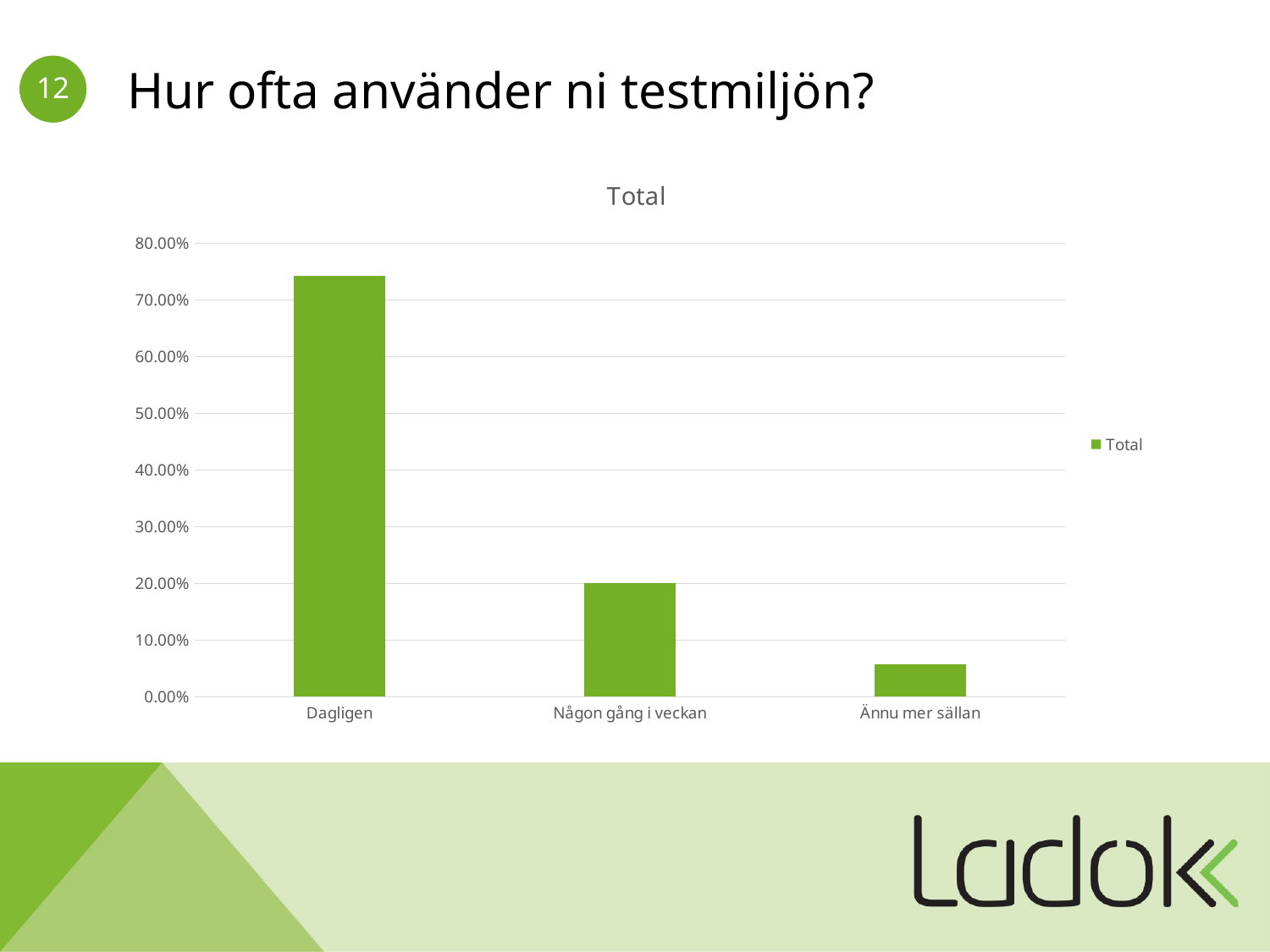
Which category has the lowest value in the chart? Ännu mer sällan Is the value for Ännu mer sällan greater or less than 10.00%? less How many categories are shown on the x axis of the chart? 3 Is the value for Dagligen greater or less than 70.00%? greater What kind of chart is shown on the slide? bar chart Do the values rise or fall from left to right along the x axis? fall What is the title of the chart? Total Is the value for Någon gång i veckan greater or less than 30.00%? less Which is larger, the value for Någon gång i veckan or the value for Ännu mer sällan? Någon gång i veckan How many series does the chart legend list? 1 Which is larger, the value for Dagligen or the value for Någon gång i veckan? Dagligen Which category has the highest value in the chart? Dagligen